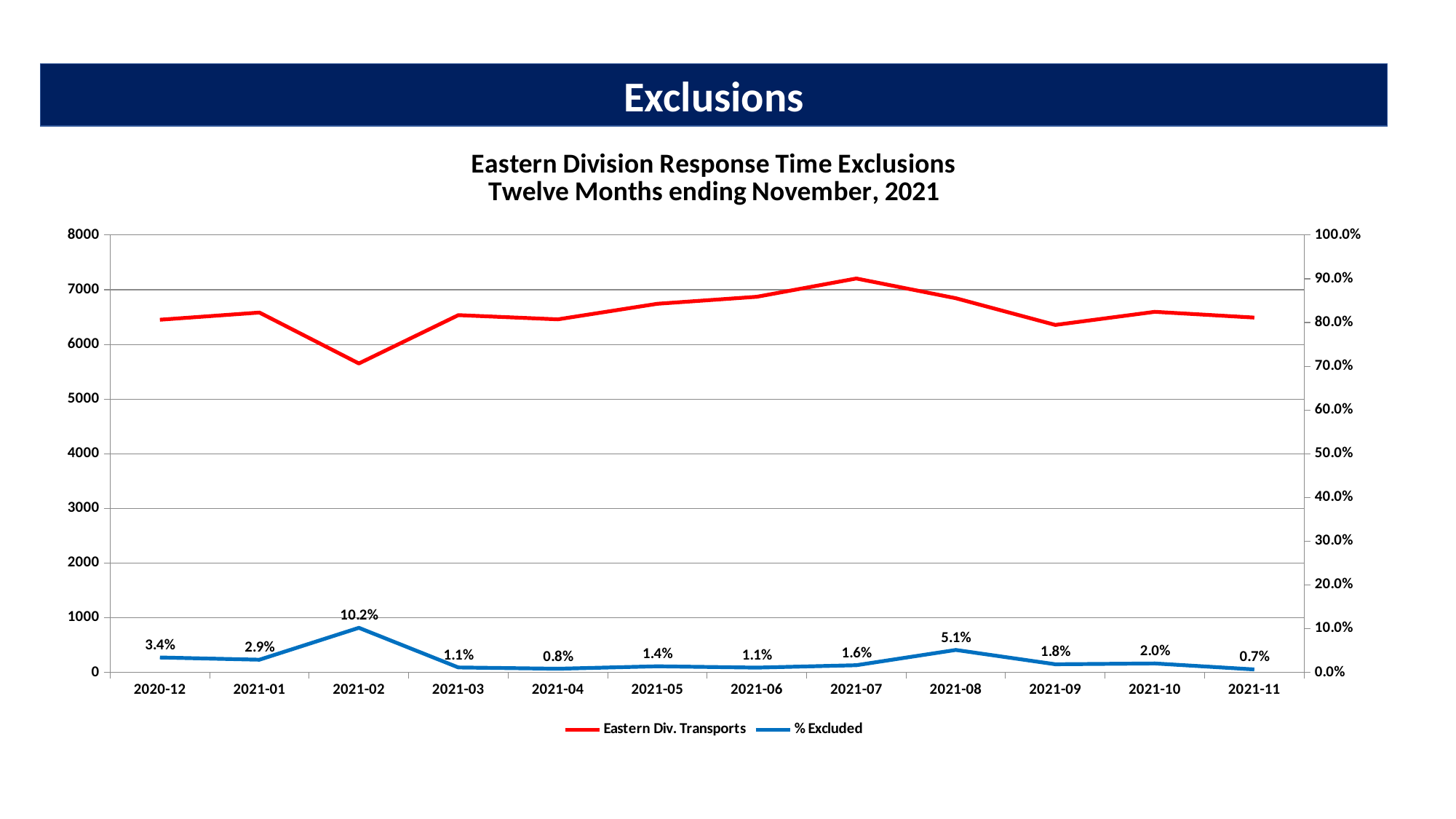
What is the % Excluded value for 2021-08? 5.1% Which month has the highest % Excluded value? 2021-02 What kind of chart is shown on the slide? line chart Which month has the lowest % Excluded value? 2021-11 How many series does the legend list? 2 What is the % Excluded value for 2021-11? 0.7% How many months are plotted on the x axis? 12 What is the % Excluded value for 2021-02? 10.2% Which is larger, the % Excluded value for 2020-12 or for 2021-01? 2020-12 What is the difference between the % Excluded values for 2021-02 and 2021-08? 5.1% Is the Eastern Div. Transports value for 2021-02 greater or less than 6000? less Is the Eastern Div. Transports value for 2021-07 greater or less than 7000? greater